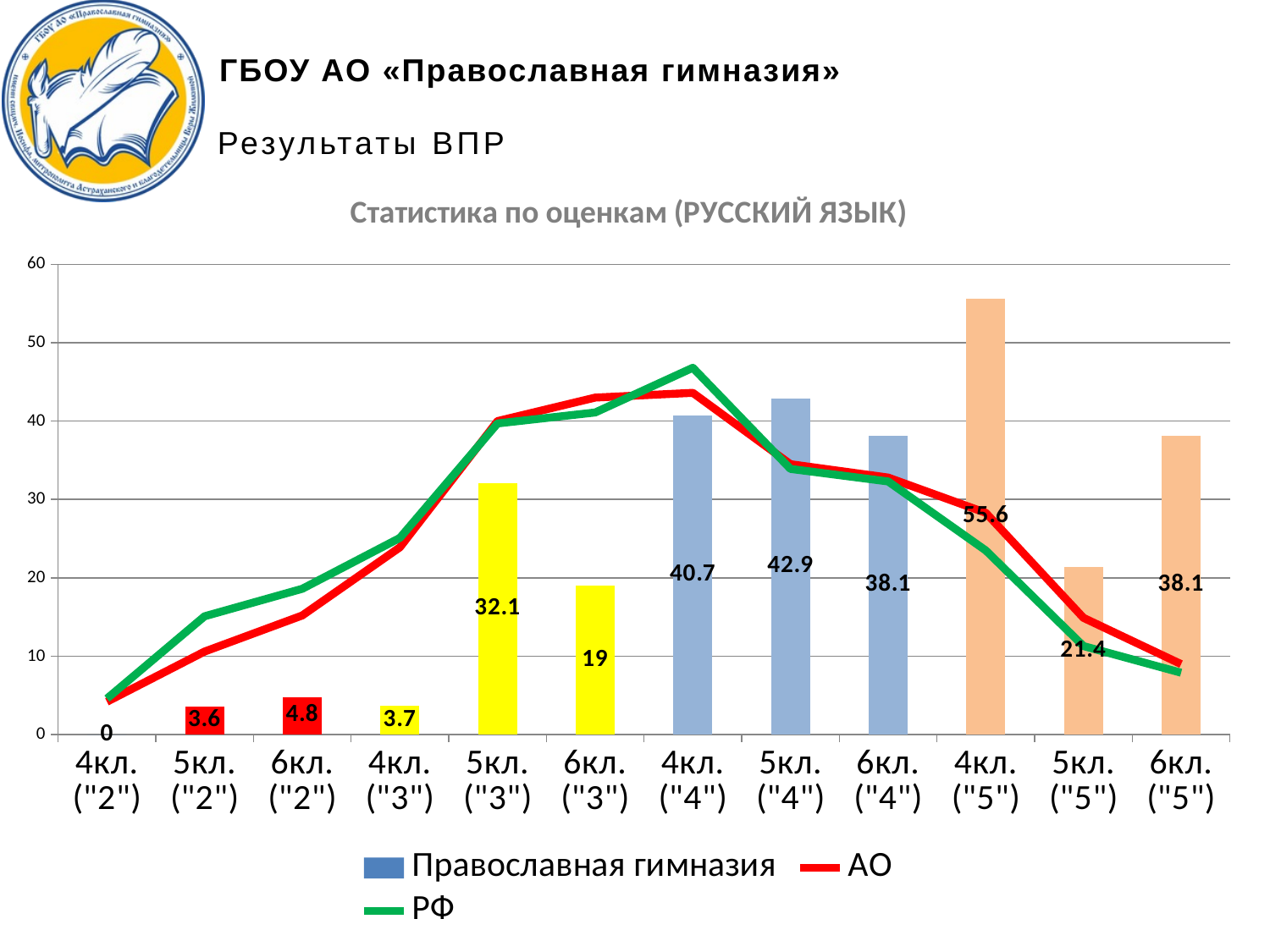
How many categories are shown on the x axis? 12 What is the difference between the Православная гимназия values for 5кл. ("4") and 4кл. ("4")? 2.2 What is the value for Православная гимназия at 5кл. ("3")? 32.1 How many series does the legend list? 3 Is the value of the РФ line at 4кл. ("4") greater or less than 40? greater Which category has the highest value for Православная гимназия? 4кл. ("5") Which category has the lowest value for Православная гимназия? 4кл. ("2") What is the value for Православная гимназия at 6кл. ("2")? 4.8 Is the value of the АО line at 5кл. ("2") greater or less than 20? less What is the value for Православная гимназия at 4кл. ("5")? 55.6 Which is larger for Православная гимназия: 5кл. ("3") or 6кл. ("3")? 5кл. ("3") What is the title of the chart? Статистика по оценкам (РУССКИЙ ЯЗЫК)